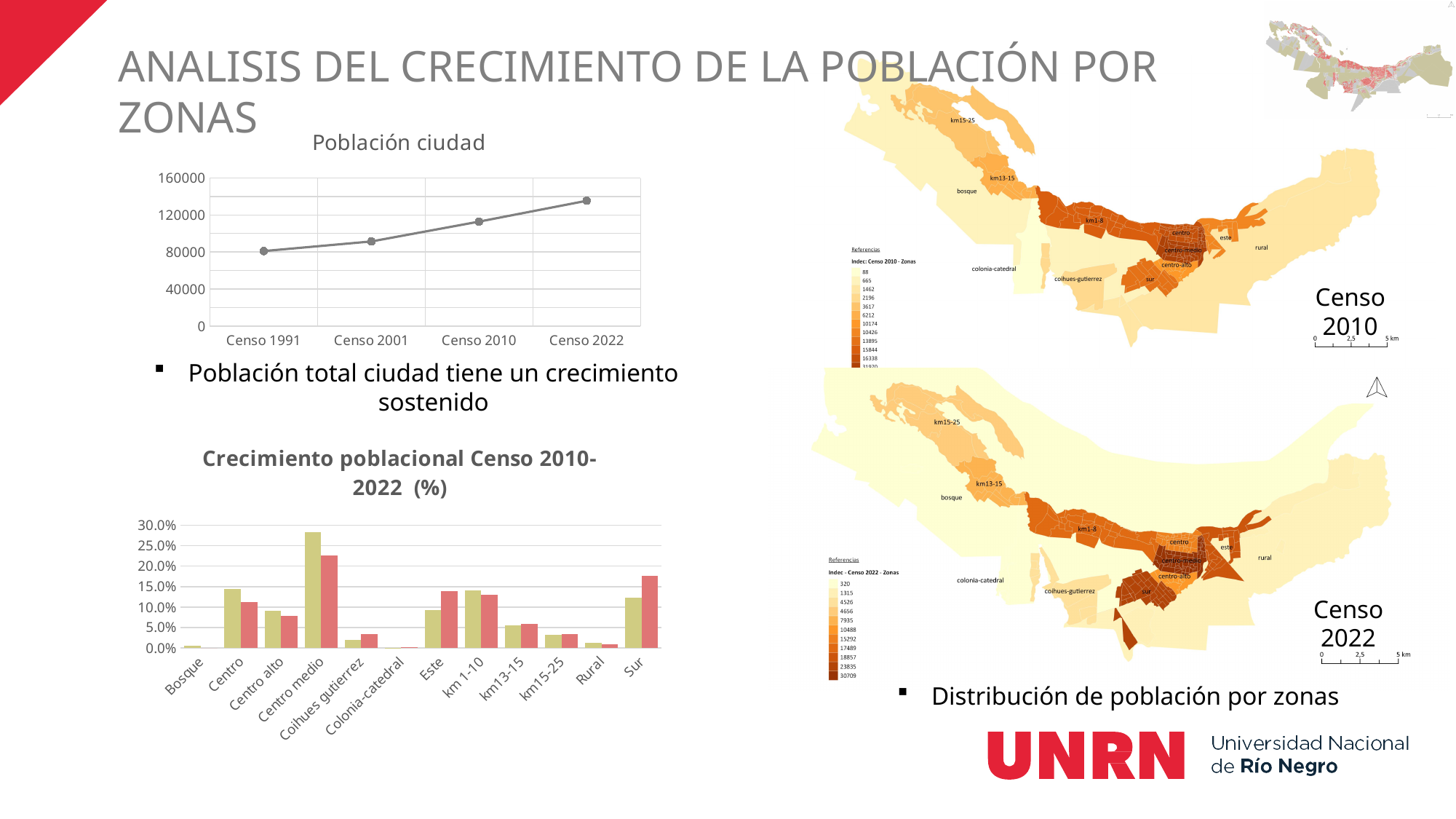
What kind of chart is the 'Población ciudad' chart? line chart In the 'Población ciudad' chart, which census has the lowest population? Censo 1991 In the 'Crecimiento poblacional Censo 2010-2022 (%)' chart, which zone has larger bars, Centro or Rural? Centro In the 'Crecimiento poblacional Censo 2010-2022 (%)' chart, how many zone categories are shown on the x axis? 12 In the 'Crecimiento poblacional Censo 2010-2022 (%)' chart, is the tallest bar for Centro medio greater or less than 25.0%? greater In the 'Población ciudad' chart, is the value for Censo 2010 greater or less than 120000? less In the 'Población ciudad' chart, is the value for Censo 2022 greater or less than 120000? greater In the 'Población ciudad' chart, do the values rise or fall from Censo 1991 to Censo 2022? rise What kind of chart is the 'Crecimiento poblacional Censo 2010-2022 (%)' chart? bar chart In the 'Población ciudad' chart, how many census points are plotted? 4 In the 'Crecimiento poblacional Censo 2010-2022 (%)' chart, which zone has the tallest bar? Centro medio In the 'Población ciudad' chart, which census has the highest population? Censo 2022